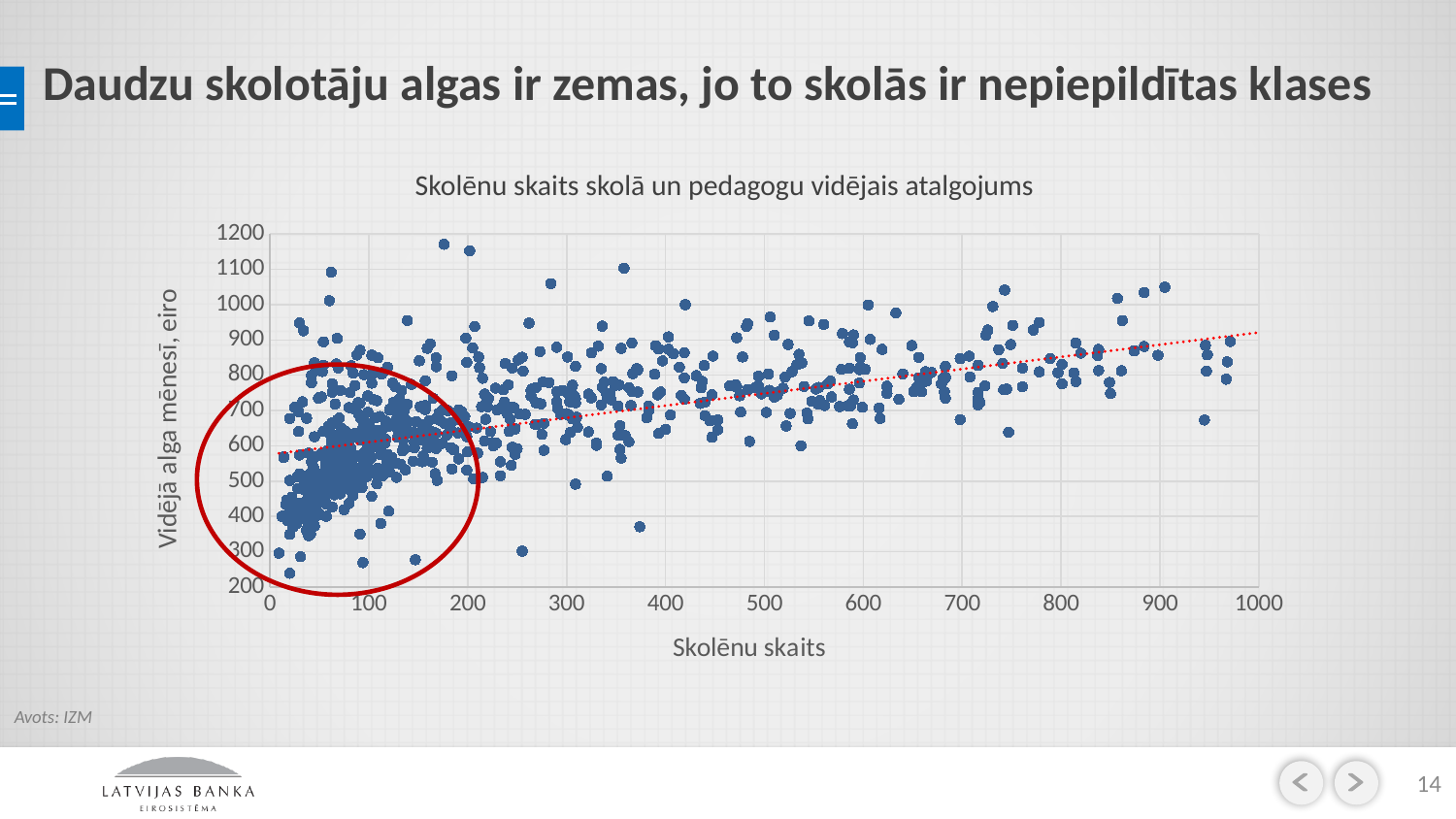
What is the title of the chart? Skolēnu skaits skolā un pedagogu vidējais atalgojums Does the dotted trend line rise or fall as the number of pupils (Skolēnu skaits) increases? rises Is the lowest plotted average salary value greater or less than 300? less Is the trend line value at 0 pupils greater or less than 700? less Is the highest plotted average salary value greater or less than 1100? greater What is the label of the x axis of the chart? Skolēnu skaits What kind of chart is shown on the slide? scatter chart